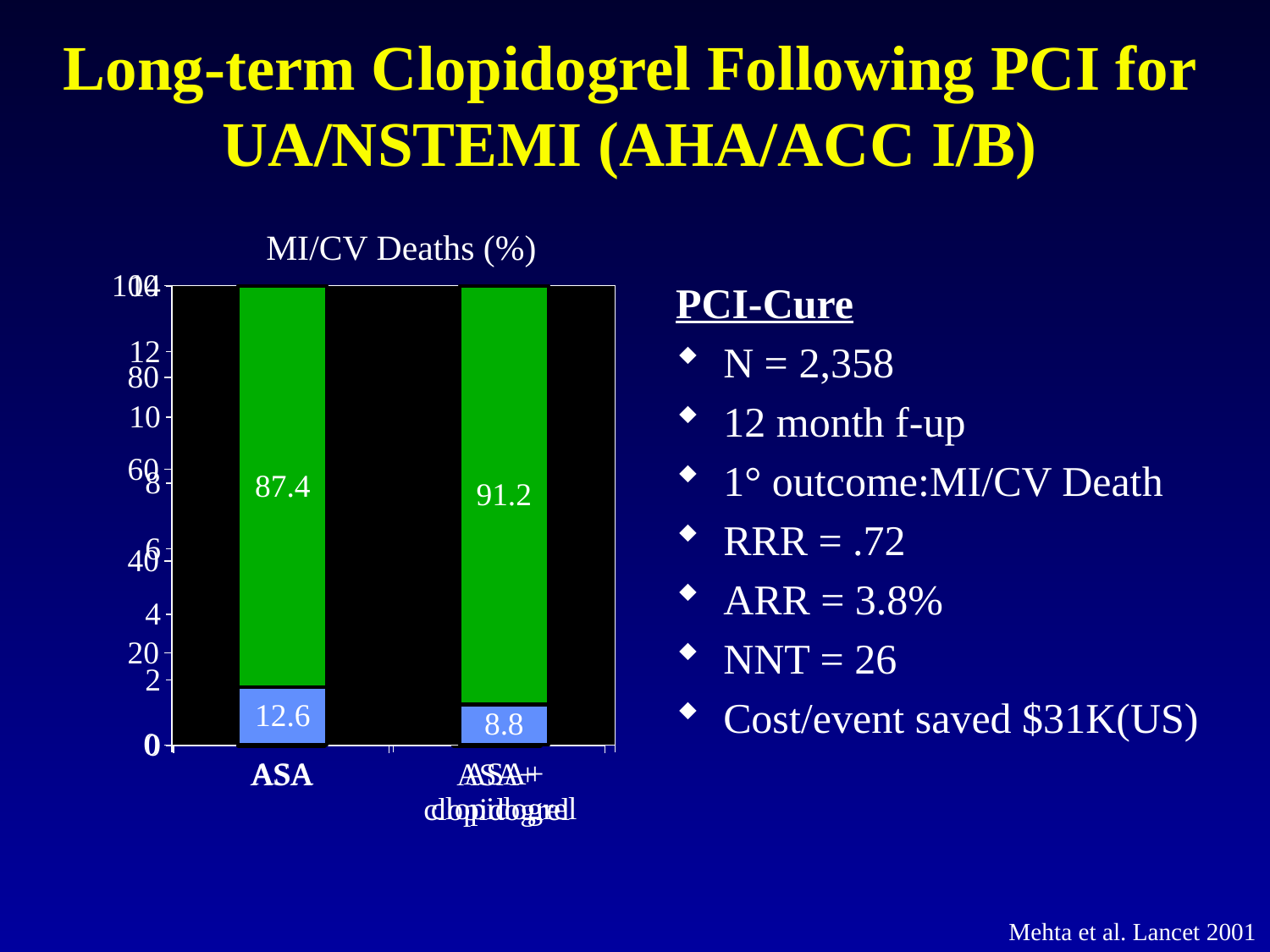
What is the value of the blue (lower) segment for ASA + clopidogrel? 8.8 What is the value of the green (upper) segment for ASA? 87.4 What type of chart is shown on the slide? bar chart What is the title of the chart? MI/CV Deaths (%) What is the value of the green (upper) segment for ASA + clopidogrel? 91.2 Which category has the larger blue (lower) segment, ASA or ASA + clopidogrel? ASA What is the total of the stacked bar for ASA? 100 Which category has the larger green (upper) segment? ASA + clopidogrel How many categories are shown on the x axis of the chart? 2 What is the value of the blue (lower) segment for ASA? 12.6 What colour is the upper segment of each bar? green What is the difference between the blue segment values for ASA and ASA + clopidogrel? 3.8